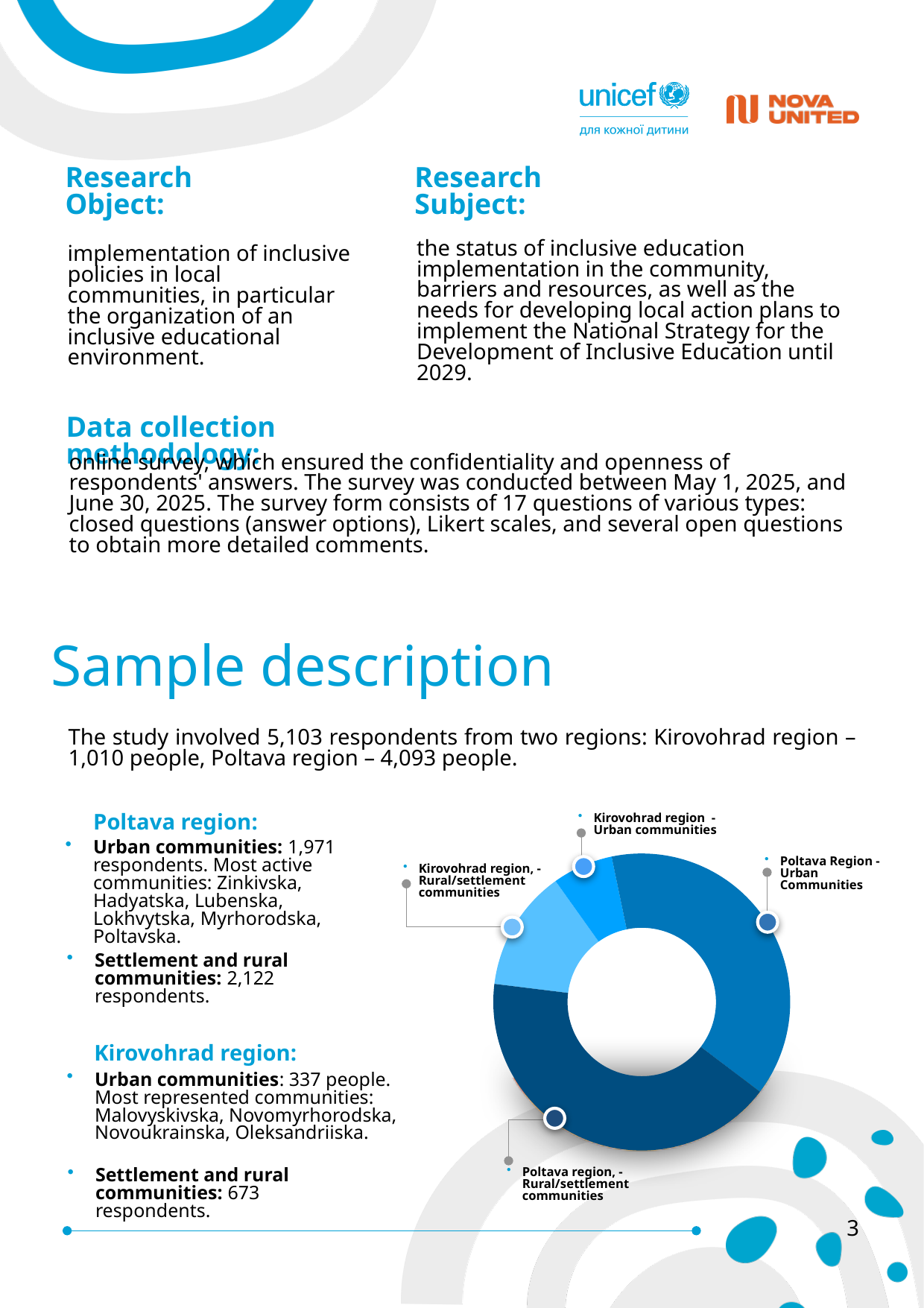
In the donut chart, which is larger: Poltava region - Rural/settlement communities or Kirovohrad region - Urban communities? Poltava region - Rural/settlement communities In the donut chart, which is larger: Poltava Region - Urban Communities or Kirovohrad region - Rural/settlement communities? Poltava Region - Urban Communities What kind of chart is shown on the slide? Pie (donut) chart Which segment of the donut chart is shown in the darkest navy blue? Poltava region - Rural/settlement communities Which segment of the donut chart is the smallest? Kirovohrad region - Urban communities How many segments does the donut chart have? 4 Which two regions are represented in the donut chart? Poltava region and Kirovohrad region In the donut chart, which is larger: Kirovohrad region - Rural/settlement communities or Kirovohrad region - Urban communities? Kirovohrad region - Rural/settlement communities